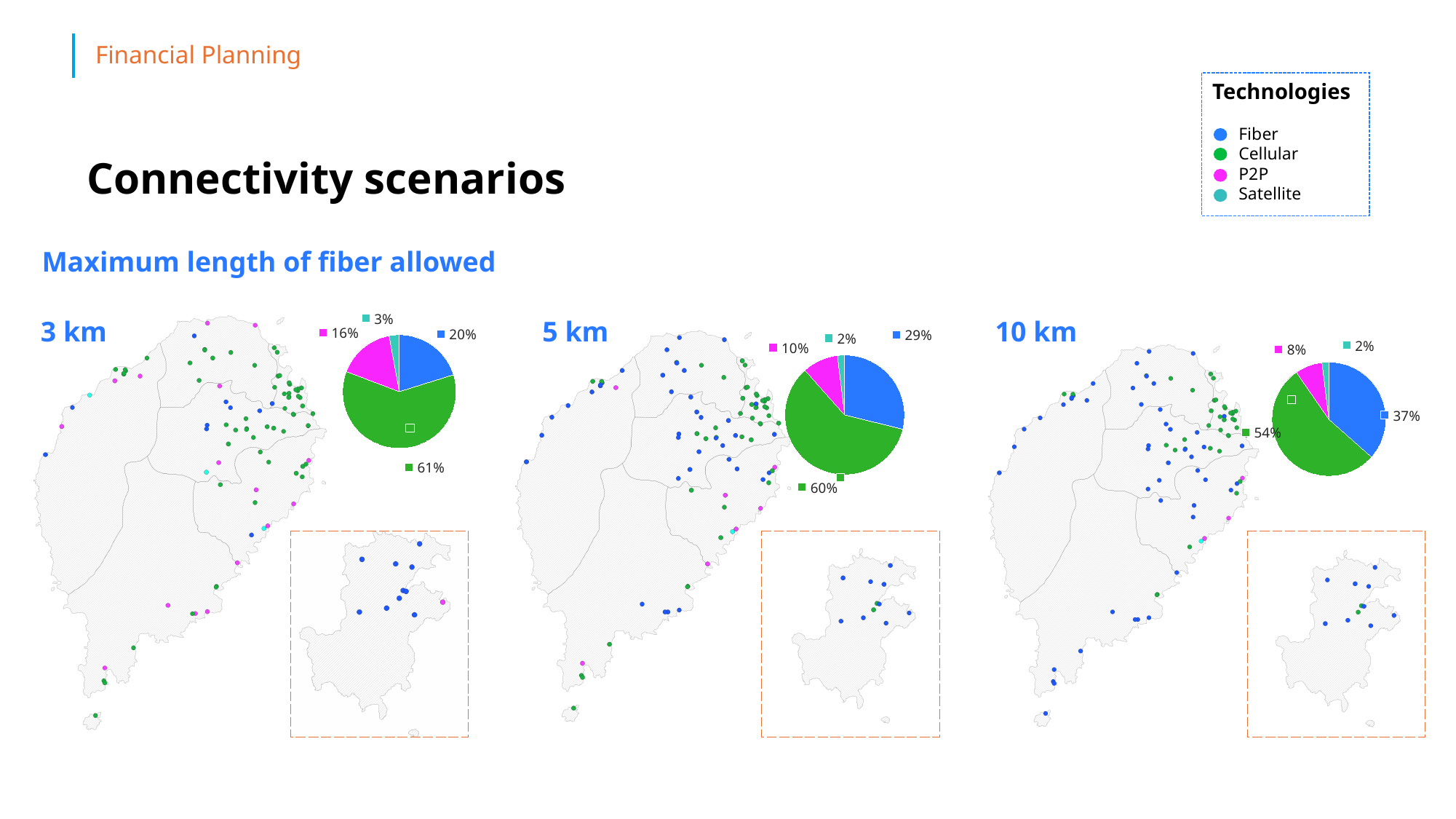
How many slices does the 5 km pie chart have? 4 In the 3 km pie chart, what share is Cellular? 61% Is the Fiber share larger in the 5 km pie chart or the 10 km pie chart? 10 km What type of chart is used to show the technology shares for each scenario? Pie chart In the 10 km pie chart, what share is Satellite? 2% In the 10 km pie chart, what is the difference between the Cellular and Fiber shares? 17% In the 5 km pie chart, which technology has the smallest share? Satellite In the 5 km pie chart, what share is Fiber? 29% In the 3 km pie chart, what is the difference between the P2P and Satellite shares? 13% In the 3 km pie chart, which technology has the largest share? Cellular How many technologies are listed in the Technologies legend? 4 In the 10 km pie chart, what share is P2P? 8%